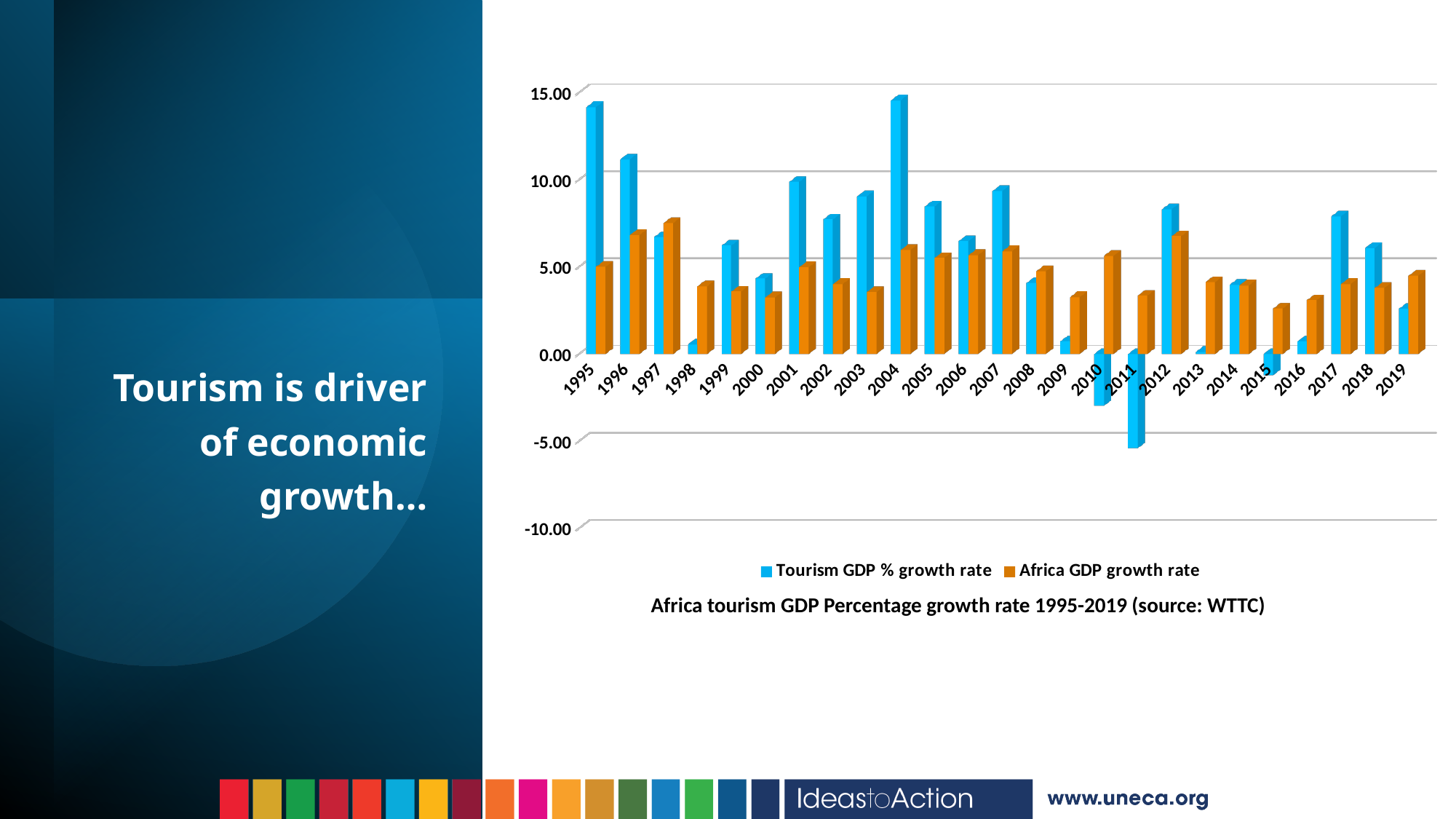
Is the Tourism GDP % growth rate for 2004 greater or less than 10.00? greater Is the Tourism GDP % growth rate for 1995 greater or less than 10.00? greater How many series does the legend list? 2 In 2015, which is larger: the Tourism GDP % growth rate or the Africa GDP growth rate? Africa GDP growth rate In 1995, which is larger: the Tourism GDP % growth rate or the Africa GDP growth rate? Tourism GDP % growth rate Which colour represents the Africa GDP growth rate series in the legend? orange Is the Africa GDP growth rate for 1997 greater or less than 5.00? greater Which year has the lowest Tourism GDP % growth rate? 2011 What kind of chart is shown on the slide? bar chart How many years are shown on the x axis of the chart? 25 What is the title of the chart? Africa tourism GDP Percentage growth rate 1995-2019 (source: WTTC)